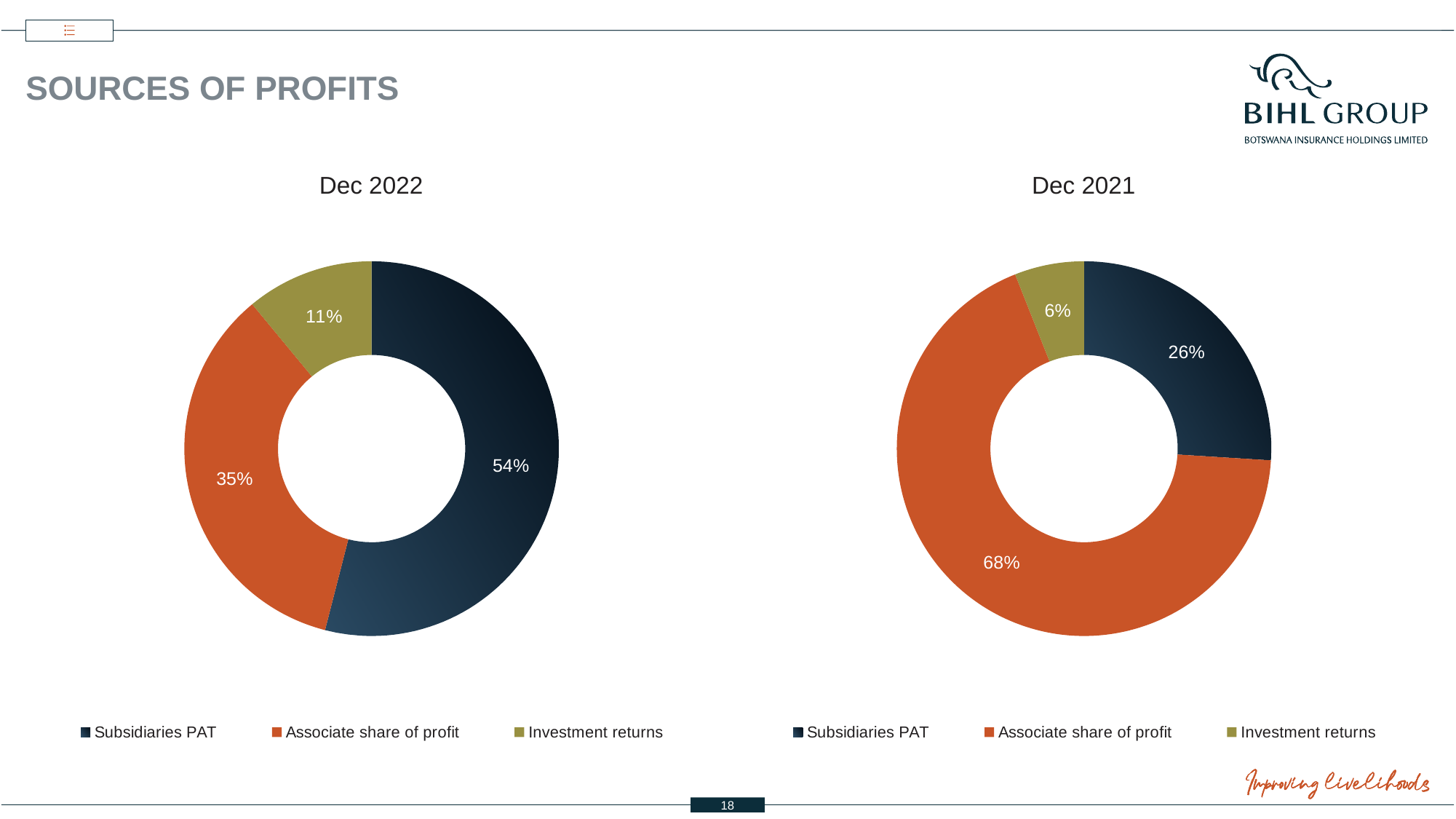
In the Dec 2021 chart, what share of profits comes from Subsidiaries PAT? 26% In the Dec 2021 chart, what is the difference in percentage points between Associate share of profit and Subsidiaries PAT? 42 In the Dec 2021 chart, what share of profits comes from Investment returns? 6% Which is larger: the Investment returns share in Dec 2022 or in Dec 2021? Dec 2022 How many slices does the Dec 2022 chart have? 3 In the Dec 2022 chart, what share of profits comes from Associate share of profit? 35% In the Dec 2022 chart, what share of profits comes from Subsidiaries PAT? 54% What kind of chart is the Dec 2021 chart? Doughnut (pie) chart In the Dec 2022 chart, what is the difference in percentage points between Subsidiaries PAT and Associate share of profit? 19 In the Dec 2021 chart, which source of profit has the largest share? Associate share of profit In the Dec 2022 chart, which source of profit has the smallest share? Investment returns In the Dec 2022 chart, what colour is the Associate share of profit slice? Orange